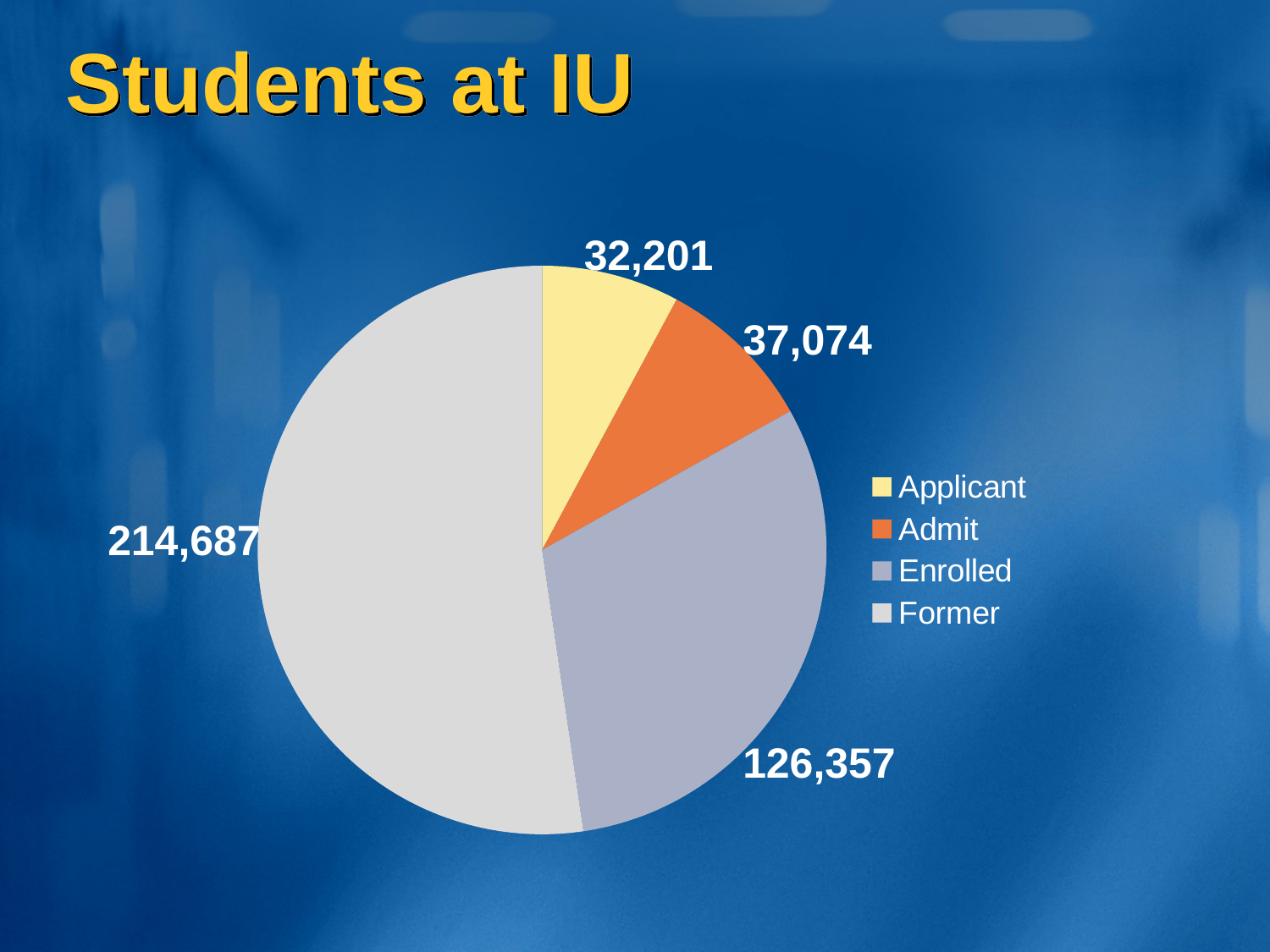
What type of chart is shown on the slide? Pie chart What is the difference between the Former and Enrolled values? 88,330 What is the value for Applicant? 32,201 What is the title of the slide containing the chart? Students at IU What is the value for Admit? 37,074 How many categories does the pie chart have? 4 What is the value for Former? 214,687 What is the value for Enrolled? 126,357 Which category has the largest slice? Former What is the difference between the Admit and Applicant values? 4,873 Which category has the smallest slice? Applicant Which is larger, Enrolled or Admit? Enrolled